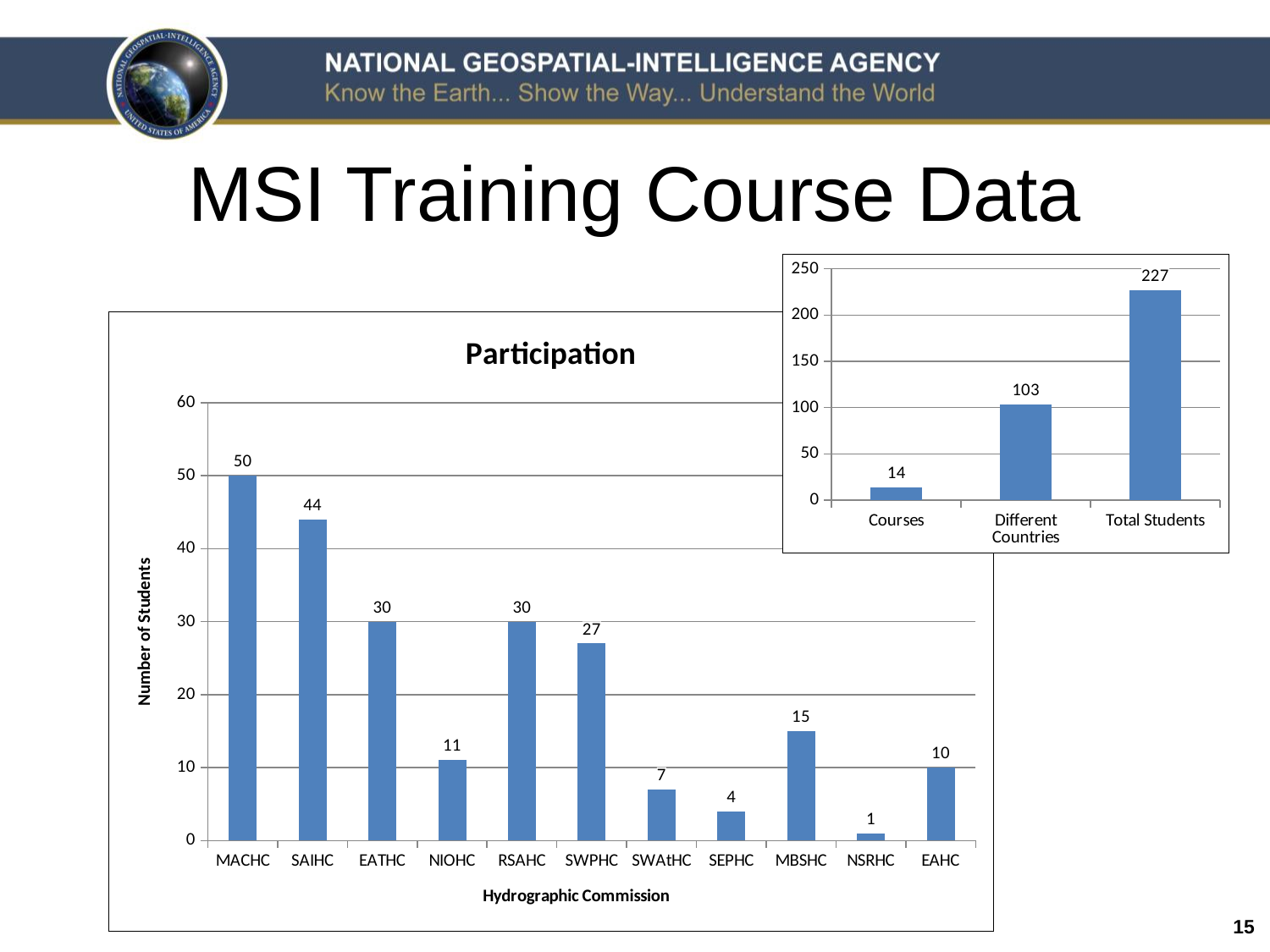
What kind of chart is the Participation chart? bar chart In the Participation chart, how many students are shown for SEPHC? 4 In the Participation chart, how many students are shown for MACHC? 50 In the Participation chart, which hydrographic commission has the lowest number of students? NSRHC In the Participation chart, what is the difference in number of students between SAIHC and SWPHC? 17 In the Participation chart, which hydrographic commission has the highest number of students? MACHC In the chart at the top right of the slide, what is the difference between Total Students and Different Countries? 124 What is the y-axis label of the Participation chart? Number of Students In the chart at the top right of the slide, what is the value for Courses? 14 In the Participation chart, which has more students, MBSHC or EAHC? MBSHC In the chart at the top right of the slide, what is the value for Different Countries? 103 In the Participation chart, how many hydrographic commissions are shown on the x axis? 11